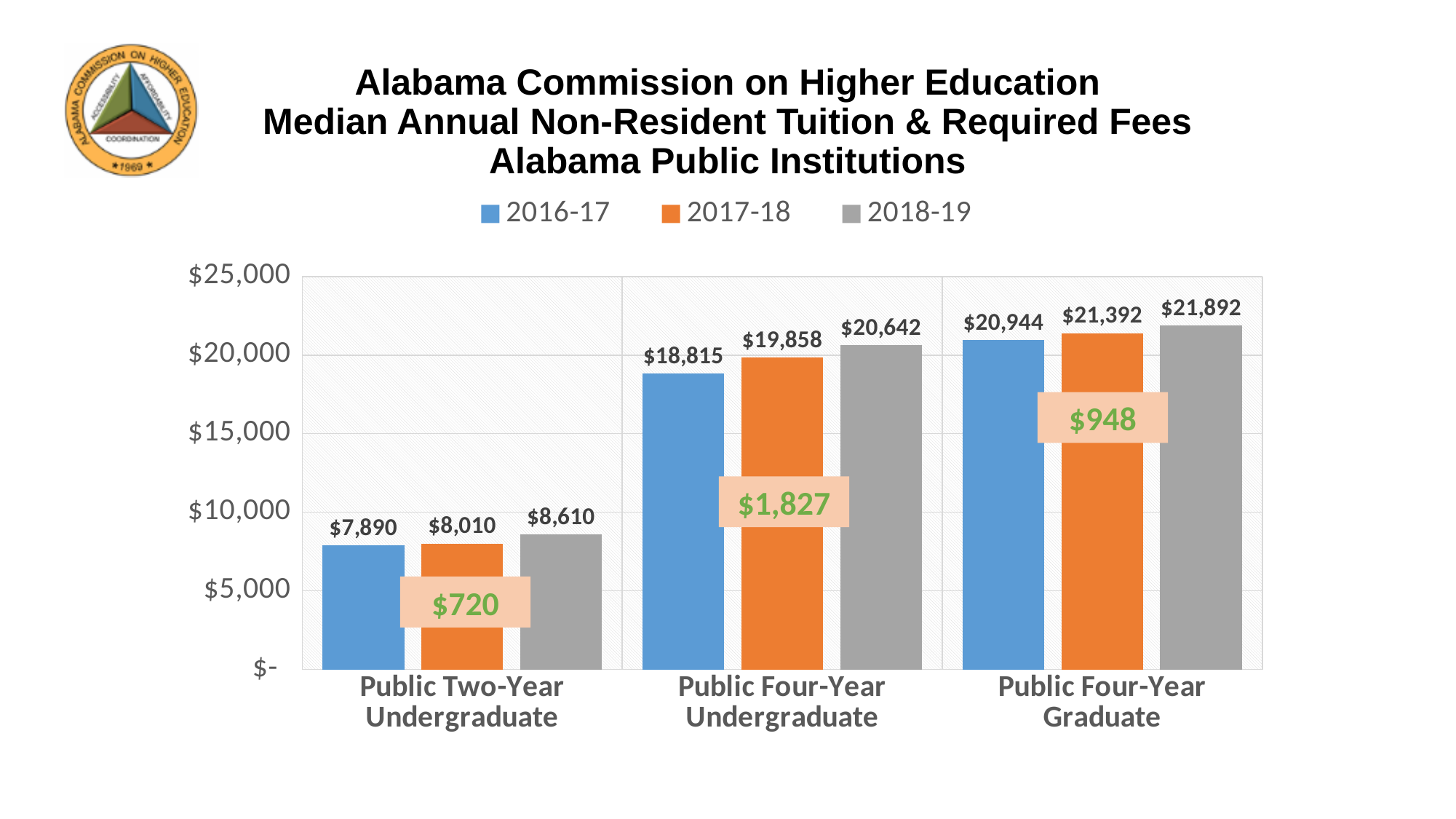
Is the 2018-19 value for Public Four-Year Undergraduate greater or less than $20,000? greater What is the difference between the 2018-19 and 2017-18 values for Public Two-Year Undergraduate? $600 What is the 2016-17 value for Public Two-Year Undergraduate? $7,890 Do the values for Public Four-Year Graduate rise or fall from 2016-17 to 2018-19? rise What is the difference between the 2018-19 and 2016-17 values for Public Four-Year Undergraduate? $1,827 What is the 2018-19 value for Public Four-Year Graduate? $21,892 How many categories are shown on the x axis? 3 What is the 2017-18 value for Public Four-Year Undergraduate? $19,858 Which category has the highest 2018-19 value? Public Four-Year Graduate How many series does the legend list? 3 Which is larger: the 2017-18 value for Public Four-Year Undergraduate or the 2016-17 value for Public Four-Year Graduate? 2016-17 value for Public Four-Year Graduate Which category has the lowest 2016-17 value? Public Two-Year Undergraduate